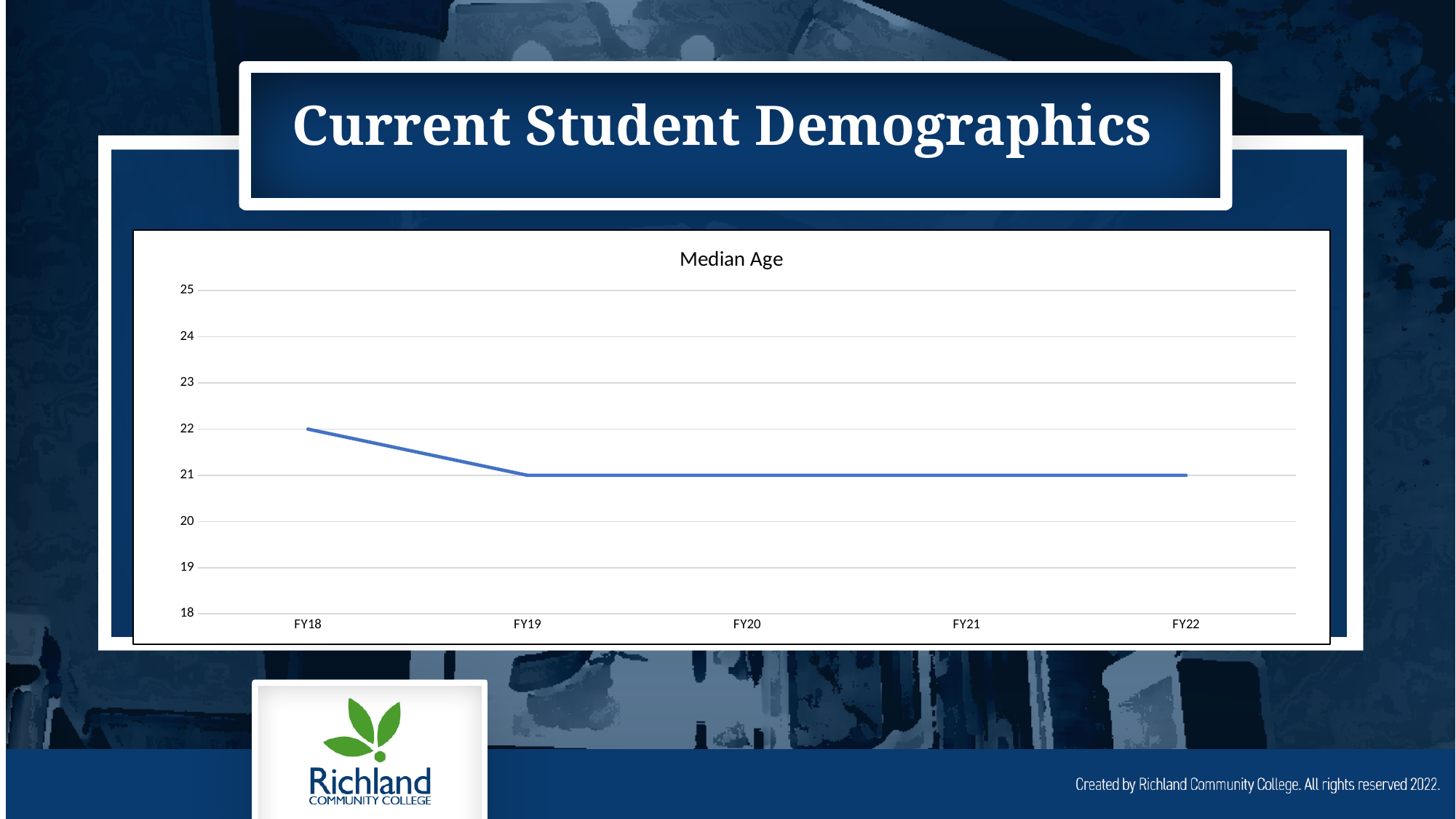
What is the difference between the median age in FY18 and FY19? 1 What kind of chart is shown on the slide? line chart Is the median age for FY21 greater or less than 23? less What is the lowest value shown on the y axis? 18 Which is larger, the median age in FY18 or in FY20? FY18 How many fiscal years are plotted on the x axis? 5 What is the median age for FY22? 21 What is the median age for FY18? 22 Which fiscal year has the highest median age? FY18 Does the median age rise or fall from FY18 to FY19? fall What is the title of the chart? Median Age What is the median age for FY19? 21